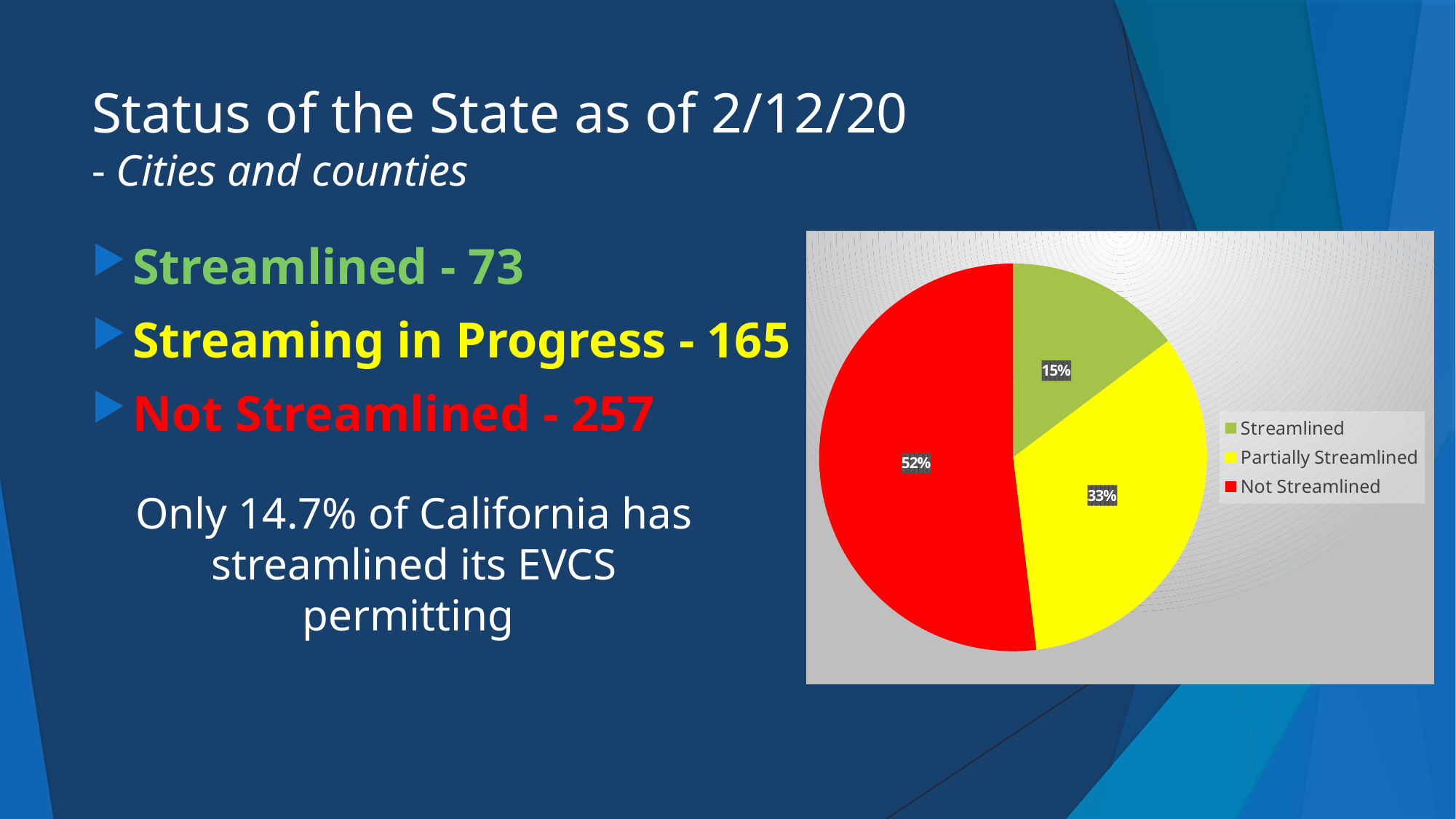
Which category has the smallest slice in the pie chart? Streamlined What is the difference in percentage points between the Partially Streamlined slice and the Streamlined slice? 18% Which category has the largest slice in the pie chart? Not Streamlined What share of the pie chart does the Partially Streamlined slice represent? 33% What share of the pie chart does the Not Streamlined slice represent? 52% What is the difference in percentage points between the Not Streamlined slice and the Partially Streamlined slice? 19% What type of chart is shown on the slide? Pie chart What share of the pie chart does the Streamlined slice represent? 15% How many entries does the chart legend list? 3 How many slices does the pie chart have? 3 Which slice is larger, Partially Streamlined or Streamlined? Partially Streamlined What colour is the Not Streamlined slice in the pie chart? Red